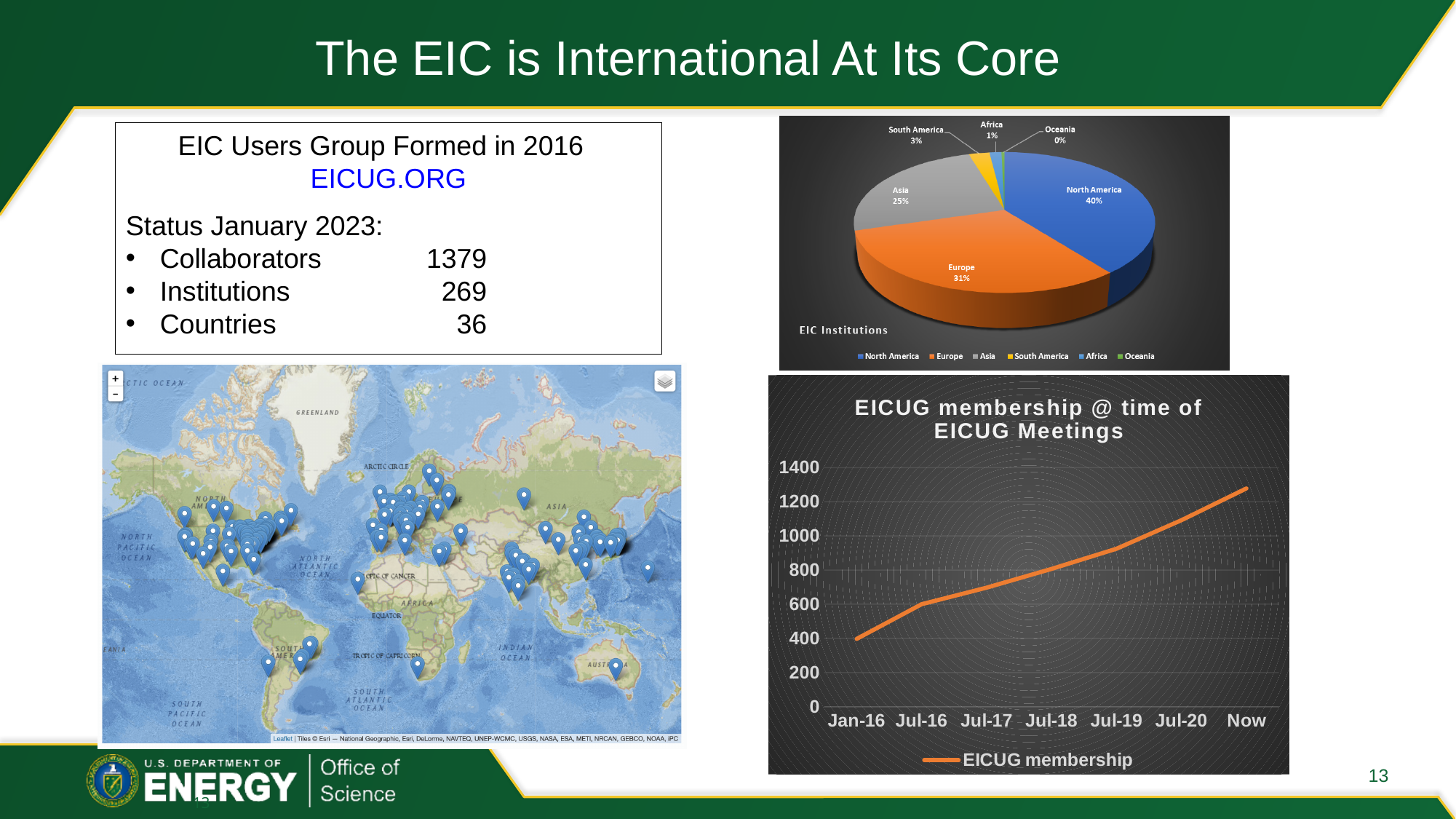
In the EIC Institutions pie chart, what share of institutions is from Europe? 31% What kind of chart is the 'EICUG membership @ time of EICUG Meetings' chart? Line chart In the 'EICUG membership @ time of EICUG Meetings' chart, is the value for Now greater or less than 1200? greater In the EIC Institutions pie chart, which region has the smallest share? Oceania In the EIC Institutions pie chart, which is larger, the South America share or the Africa share? South America In the EIC Institutions pie chart, which region has the largest share? North America In the 'EICUG membership @ time of EICUG Meetings' chart, does membership rise or fall from Jan-16 to Now? Rise In the EIC Institutions pie chart, what is the difference between the Europe and Asia shares? 6% In the EIC Institutions pie chart, what share of institutions is from North America? 40% In the 'EICUG membership @ time of EICUG Meetings' chart, how many points are plotted along the x axis? 7 In the EIC Institutions pie chart, what share of institutions is from Asia? 25% How many regions does the legend of the EIC Institutions pie chart list? 6